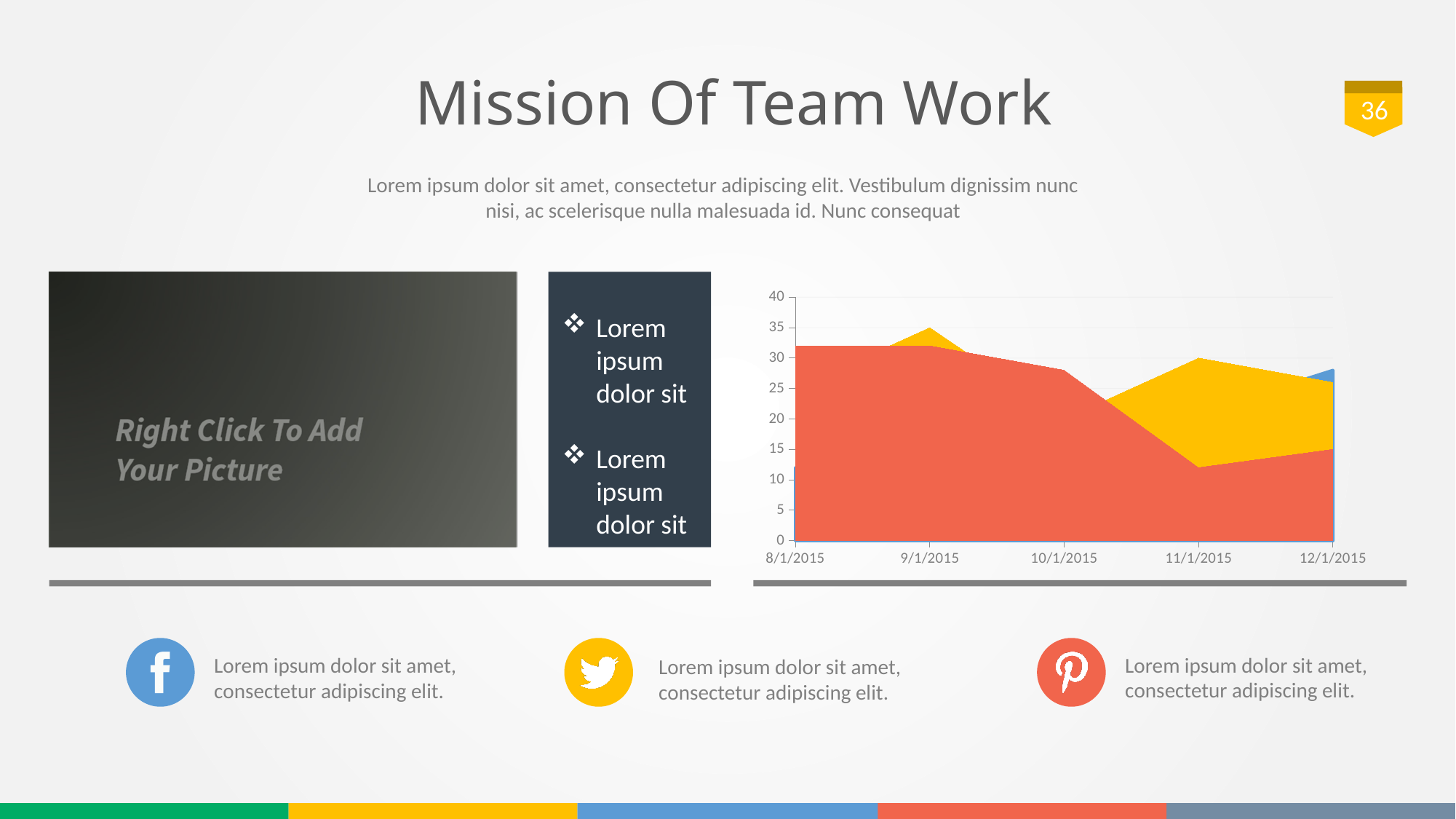
Is the value of the blue series at 12/1/2015 greater or less than 25? greater What kind of chart is shown on the slide? area chart Is the value of the red series at 10/1/2015 greater or less than 25? greater Is the value of the yellow series at 11/1/2015 greater or less than 25? greater How many dates are labelled along the x axis of the chart? 5 Which is larger for the red series: the value at 8/1/2015 or the value at 11/1/2015? 8/1/2015 Does the red series rise or fall from 8/1/2015 to 12/1/2015? fall At which date does the red series reach its lowest value? 11/1/2015 What is the first date shown on the x axis of the chart? 8/1/2015 What is the highest value shown on the y axis of the chart? 40